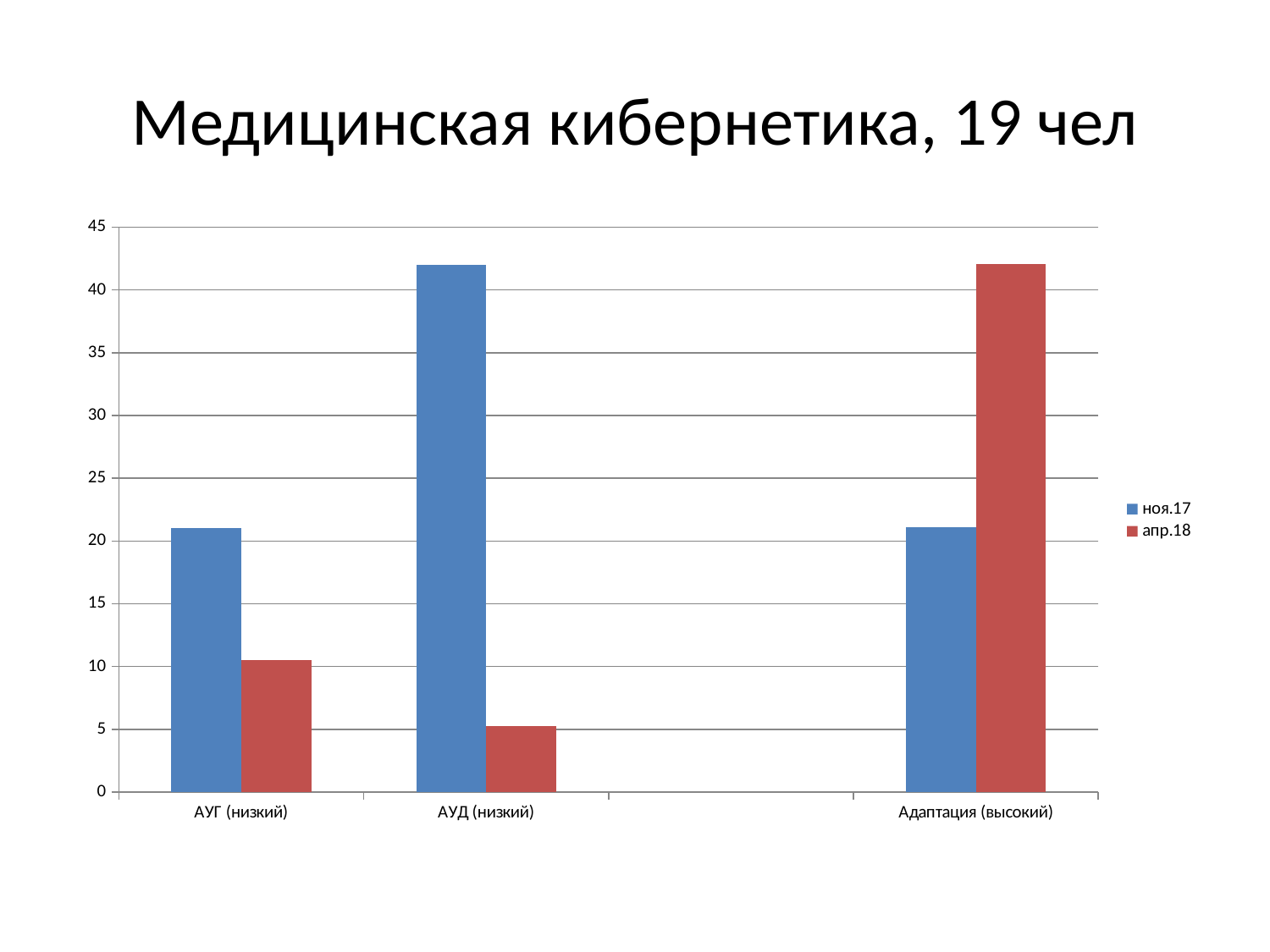
Which category has the lowest апр.18 value? АУД (низкий) For Адаптация (высокий), which series has the larger value, ноя.17 or апр.18? апр.18 What are the two series named in the legend? ноя.17 and апр.18 What kind of chart is shown on the slide? bar chart What is the title of the slide? Медицинская кибернетика, 19 чел Is the апр.18 value for Адаптация (высокий) greater or less than 40? greater Which category has the highest апр.18 value? Адаптация (высокий) Is the апр.18 value for АУГ (низкий) greater or less than 15? less Is the ноя.17 value for АУД (низкий) greater or less than 40? greater How many series does the legend list? 2